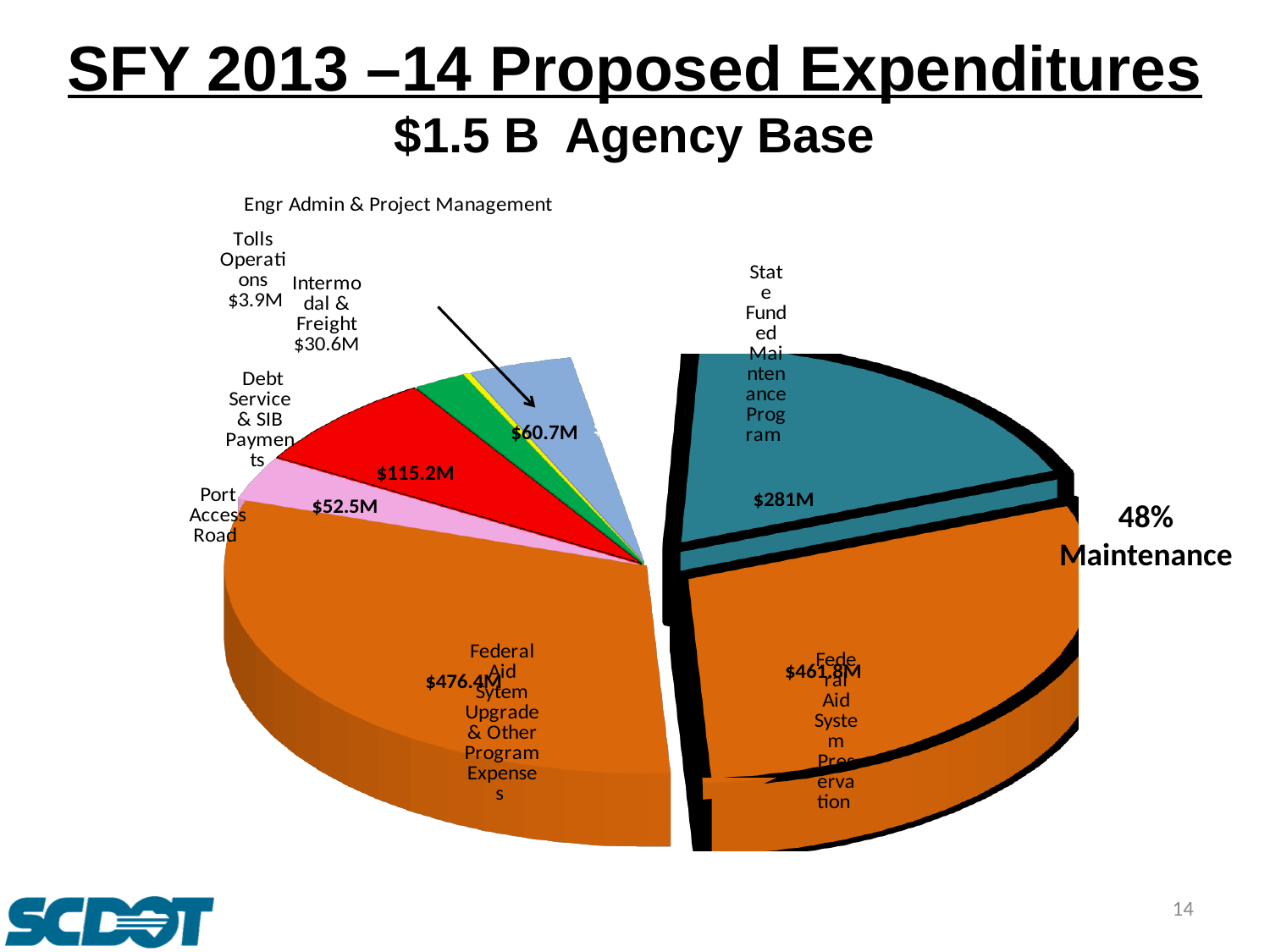
What type of chart is shown on the slide? pie chart Which slice has the largest value? Federal Aid System Upgrade & Other Program Expenses What is the value for Debt Service & SIB Payments? $115.2M What is the value for Port Access Road? $52.5M What is the value for the State Funded Maintenance Program slice? $281M Which is larger, Debt Service & SIB Payments or Port Access Road? Debt Service & SIB Payments Which slice has the smallest value? Tolls Operations What is the difference between Federal Aid System Upgrade & Other Program Expenses and Federal Aid System Preservation? $14.6M What is the value for Engr Admin & Project Management? $60.7M What percentage is labeled as Maintenance on the slide? 48% What is the value for Intermodal & Freight? $30.6M